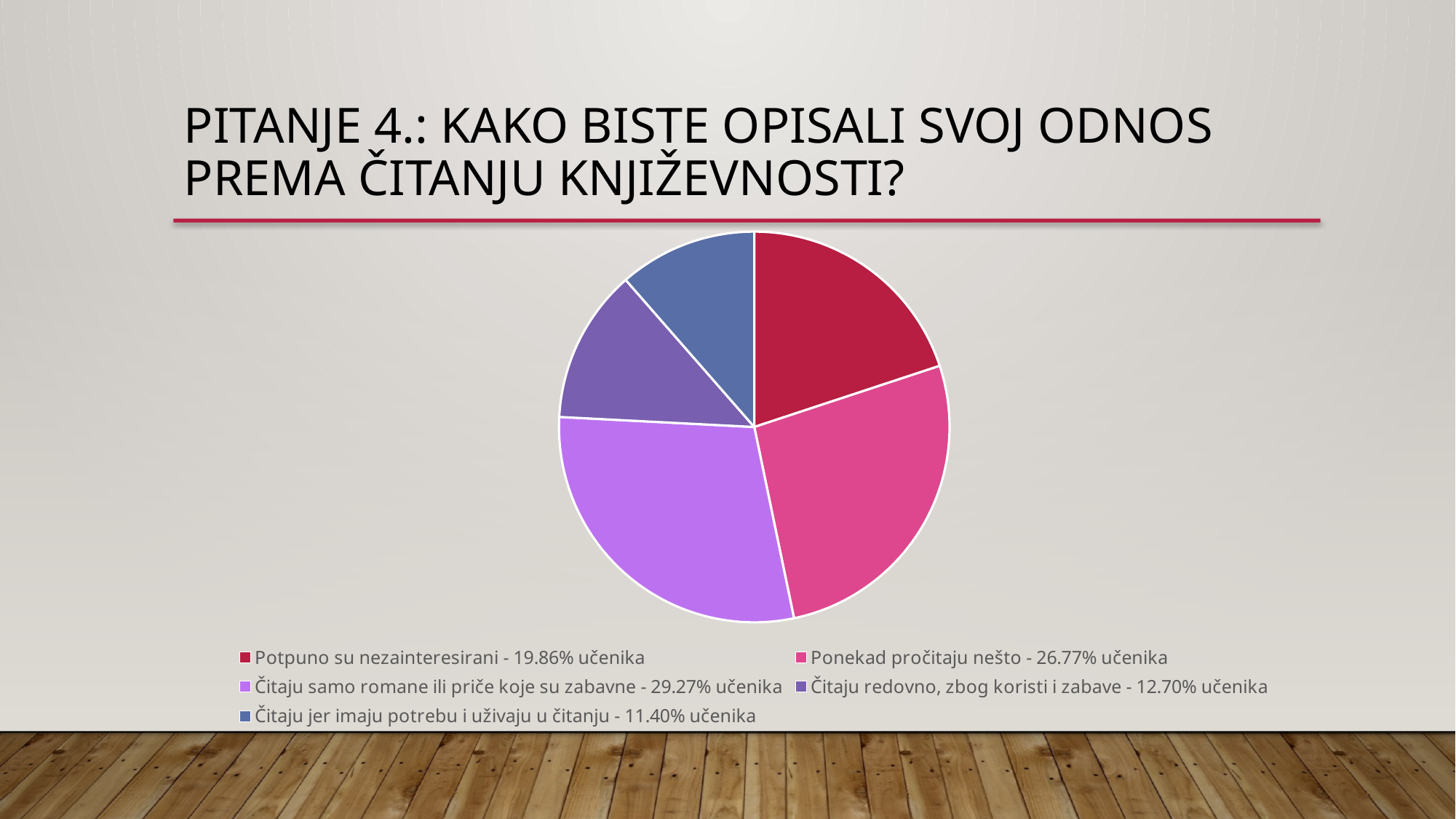
What kind of chart is shown on the slide? pie chart What percentage of students 'Ponekad pročitaju nešto'? 26.77% Which category has the smallest share of the pie? Čitaju jer imaju potrebu i uživaju u čitanju - 11.40% učenika What colour is the slice for 'Potpuno su nezainteresirani'? dark red How many slices does the pie chart have? 5 Which is larger: the share for 'Ponekad pročitaju nešto' or the share for 'Čitaju redovno, zbog koristi i zabave'? Ponekad pročitaju nešto What percentage of students 'Čitaju jer imaju potrebu i uživaju u čitanju'? 11.40% Which category has the largest share of the pie? Čitaju samo romane ili priče koje su zabavne - 29.27% učenika What is the difference in percentage points between 'Čitaju samo romane ili priče koje su zabavne' and 'Potpuno su nezainteresirani'? 9.41 What percentage of students are 'Potpuno su nezainteresirani'? 19.86% What is the combined share of 'Čitaju redovno, zbog koristi i zabave' and 'Čitaju jer imaju potrebu i uživaju u čitanju'? 24.10% What percentage of students 'Čitaju redovno, zbog koristi i zabave'? 12.70%